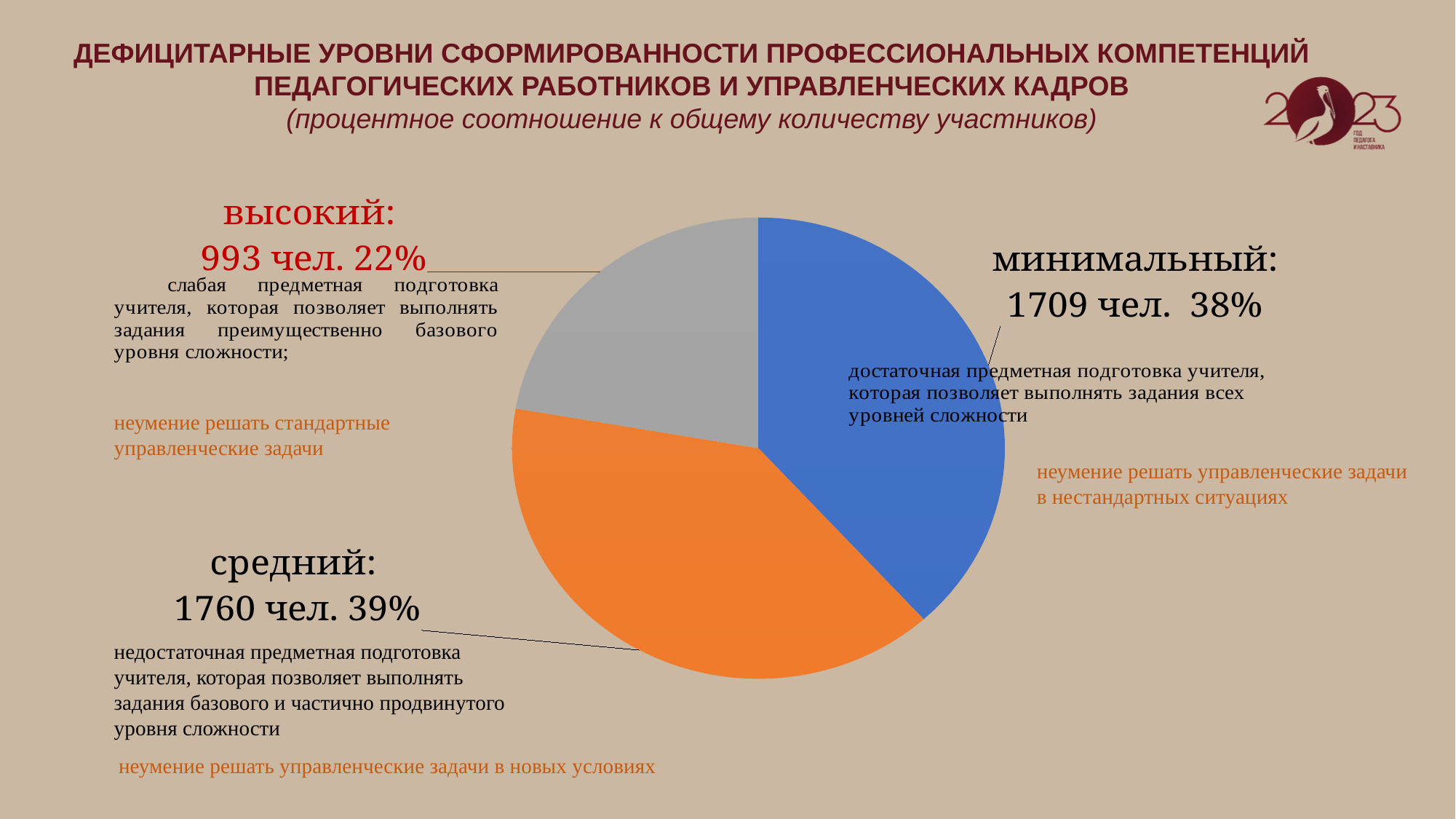
How many slices does the pie chart have? 3 What colour is the slice for the "средний" level? orange What is the difference in number of people between the "средний" and "высокий" levels? 767 Which level has the smallest slice of the pie? высокий How many people are in the "высокий" level? 993 чел. Which is larger: the "средний" slice or the "высокий" slice? средний What percentage share does the "высокий" level have? 22% What is the difference in number of people between the "средний" and "минимальный" levels? 51 How many people are in the "минимальный" level? 1709 чел. What percentage share does the "средний" level have? 39% What colour is the slice for the "минимальный" level? blue What kind of chart is shown on the slide? pie chart